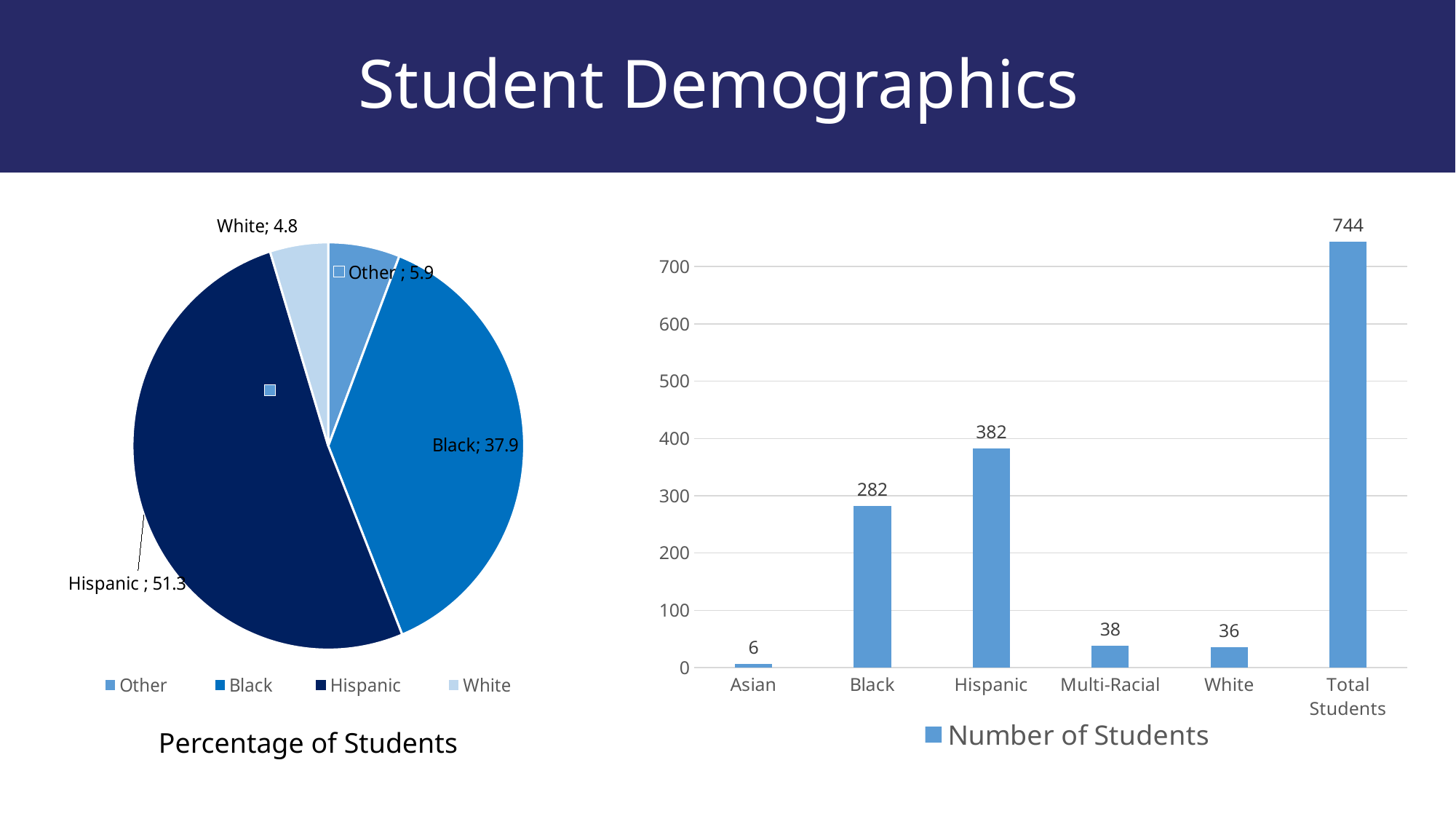
In the pie chart on the left, what is the value shown for Hispanic? 51.3 What type of chart is shown on the right side of the slide? Bar chart In the pie chart on the left, what is the difference between the Hispanic and Black values? 13.4 In the bar chart on the right, which category has the lowest value? Asian In the bar chart on the right, what is the difference between the Hispanic and Black values? 100 In the bar chart on the right, which is larger, the value for Multi-Racial or the value for White? Multi-Racial In the pie chart on the left, what is the value shown for White? 4.8 In the bar chart on the right, what is the value for Hispanic? 382 In the pie chart on the left, which category has the largest slice? Hispanic In the pie chart on the left, how many categories does the legend list? 4 In the bar chart on the right, what is the value for Multi-Racial? 38 In the pie chart on the left, which category has the smallest slice? White